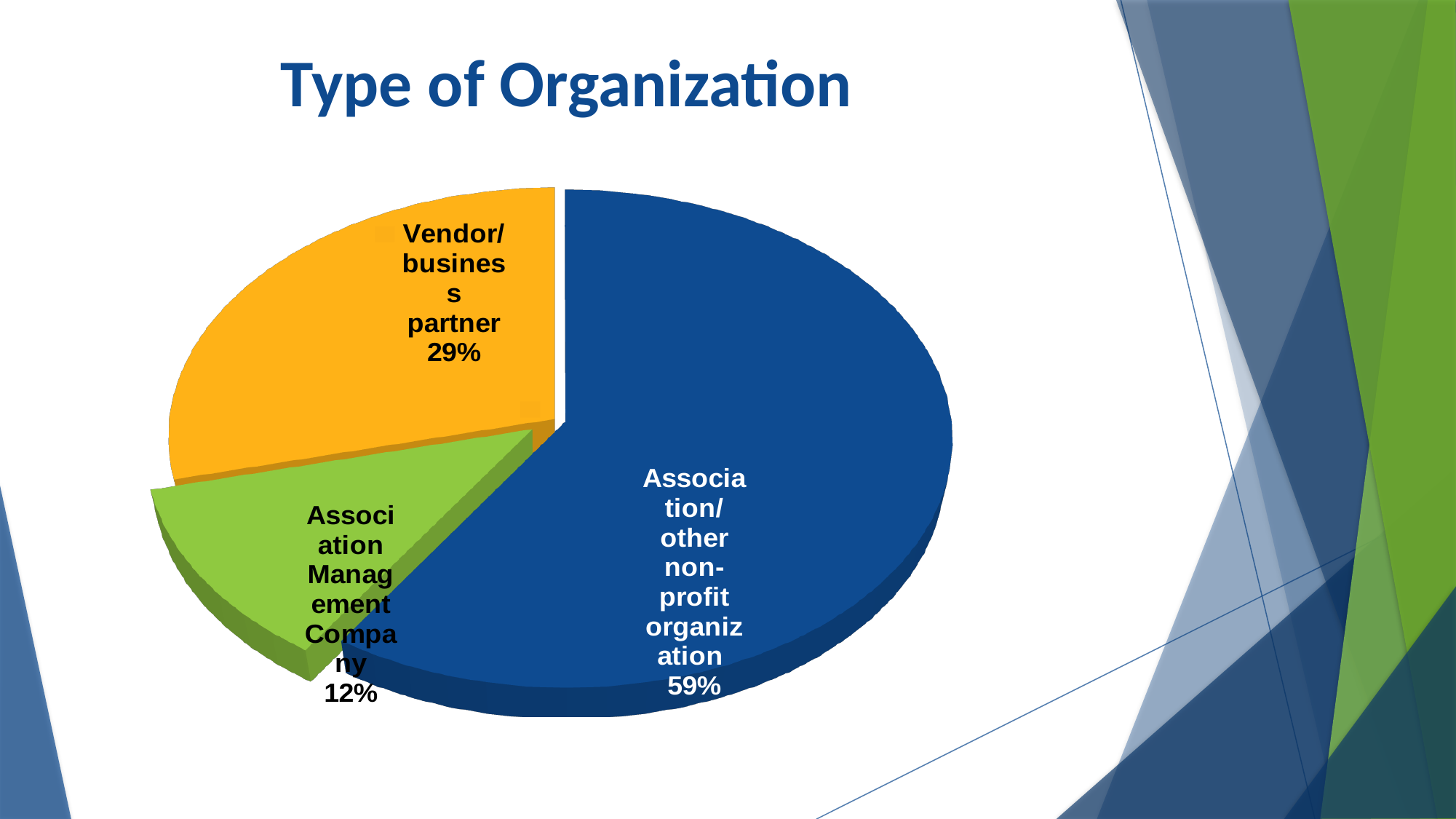
What share of the pie does Association Management Company represent? 12% Which category has the smallest slice of the pie? Association Management Company What kind of chart is shown on the slide? Pie chart What is the difference in percentage points between Association/other non-profit organization and Vendor/business partner? 30 Which is larger, the share for Vendor/business partner or the share for Association Management Company? Vendor/business partner What is the title of the chart on the slide? Type of Organization What share of the pie does Association/other non-profit organization represent? 59% What is the difference in percentage points between Vendor/business partner and Association Management Company? 17 What colour is the slice for Association Management Company? Green What share of the pie does Vendor/business partner represent? 29% How many categories are shown in the pie chart? 3 Which category has the largest slice of the pie? Association/other non-profit organization